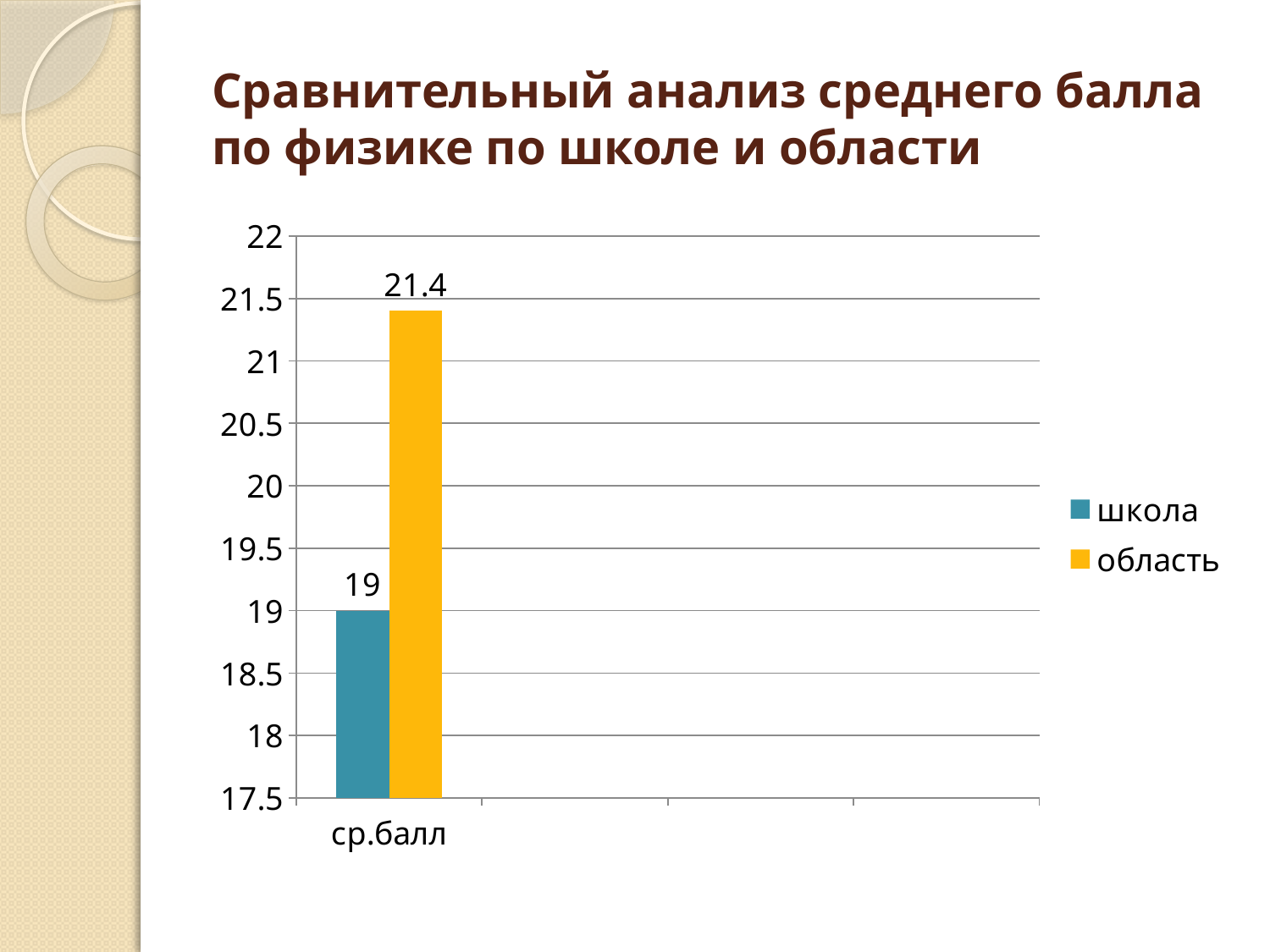
What is the category label on the x axis? ср.балл What is the difference between the область value and the школа value? 2.4 Is the value for область greater or less than 21? greater What is the value for область in the chart? 21.4 What colour is the bar for область? yellow How many categories are shown on the x axis? 1 Which series has the higher value, школа or область? область What kind of chart is shown on the slide? bar chart Is the value for школа greater or less than 19.5? less What is the value for школа in the chart? 19 Which series has the lowest value? школа How many series does the legend list? 2